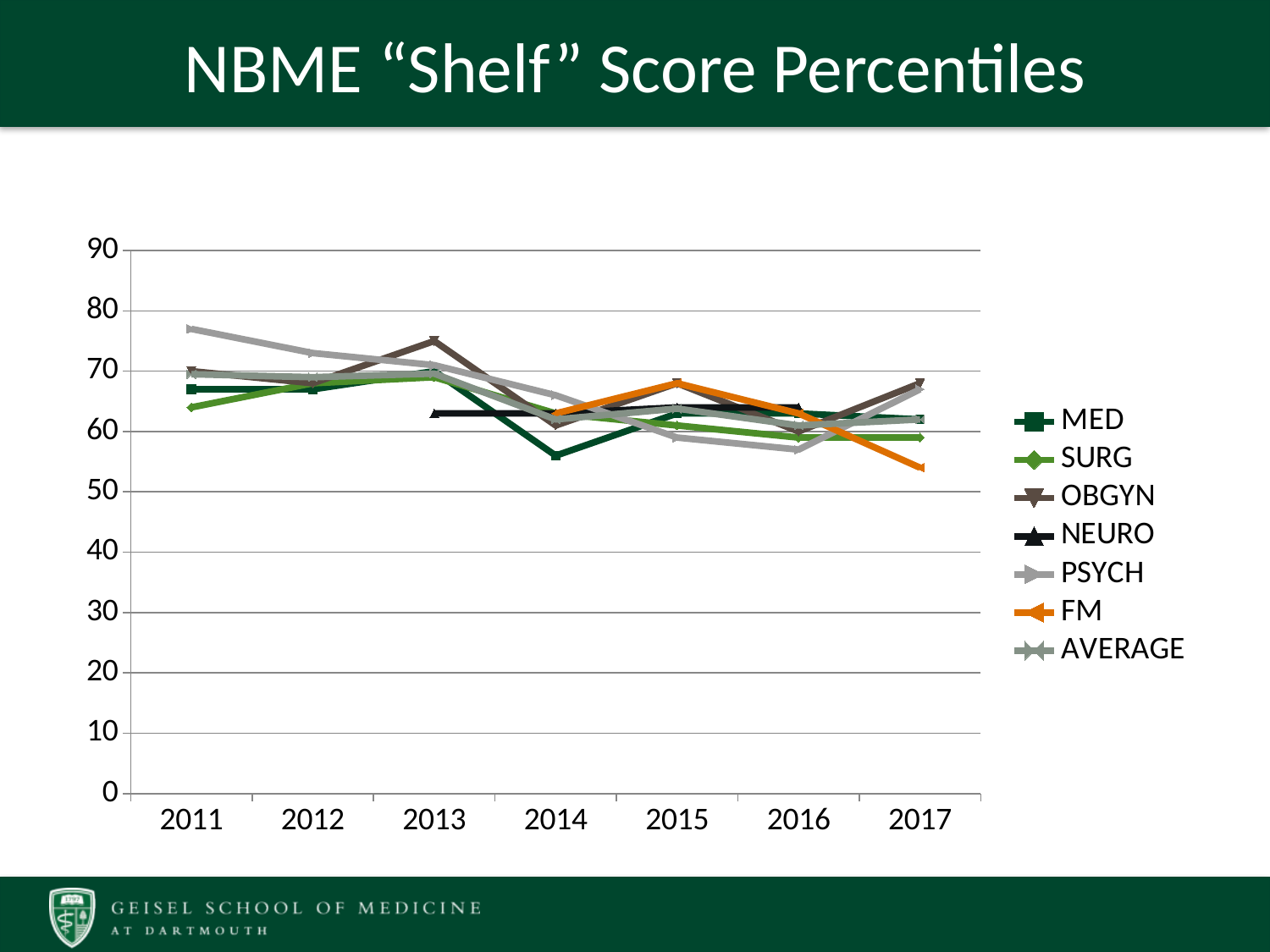
Is the value for MED in 2014 greater or less than 60? less Which series has the lowest value in 2014? MED Which series has the highest value in 2013? OBGYN How many years are shown on the x axis? 7 Is the value for FM in 2017 greater or less than 60? less What kind of chart is shown on the slide? line chart Does the PSYCH line rise or fall from 2011 to 2016? fall Which series has the highest value in 2011? PSYCH Is the value for PSYCH in 2011 greater or less than 70? greater How many series does the legend list? 7 What is the title of the chart? NBME "Shelf" Score Percentiles Which series has the lowest value in 2017? FM